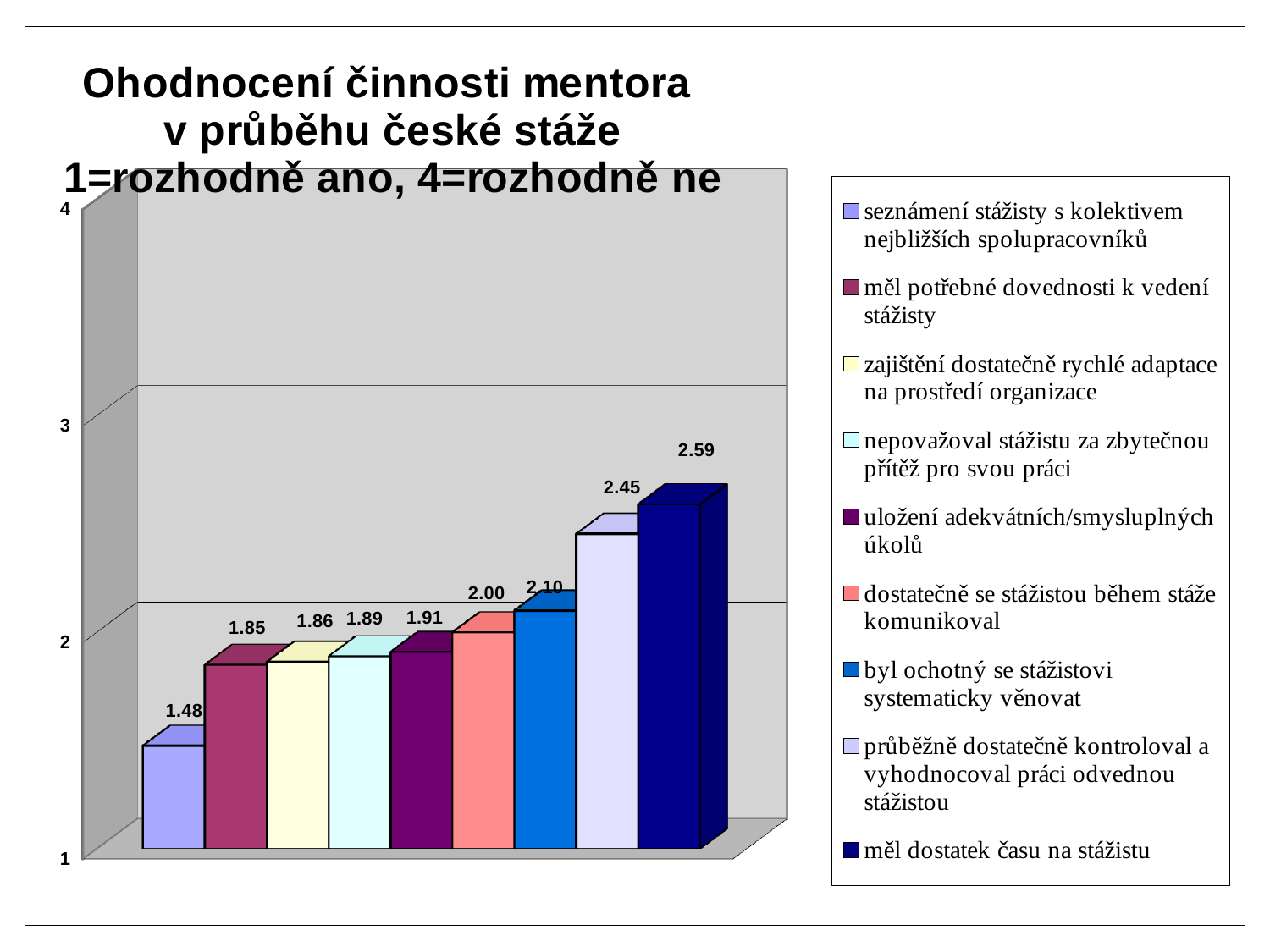
What is the value for "byl ochotný se stážistovi systematicky věnovat"? 2.10 Which is larger: the value for "uložení adekvátních/smysluplných úkolů" or the value for "byl ochotný se stážistovi systematicky věnovat"? byl ochotný se stážistovi systematicky věnovat What is the value for "dostatečně se stážistou během stáže komunikoval"? 2.00 Is the value for "průběžně dostatečně kontroloval a vyhodnocoval práci odvedenou stážistou" greater or less than 2? greater Which legend entry has the highest value? měl dostatek času na stážistu What kind of chart is shown on the slide? bar chart Which legend entry has the lowest value? seznámení stážisty s kolektivem nejbližších spolupracovníků What is the difference between the values for "měl dostatek času na stážistu" and "průběžně dostatečně kontroloval a vyhodnocoval práci odvedenou stážistou"? 0.14 How many series does the legend list? 9 What is the value for "měl dostatek času na stážistu"? 2.59 Do the bar values rise or fall from left to right? rise What is the value for "seznámení stážisty s kolektivem nejbližších spolupracovníků"? 1.48